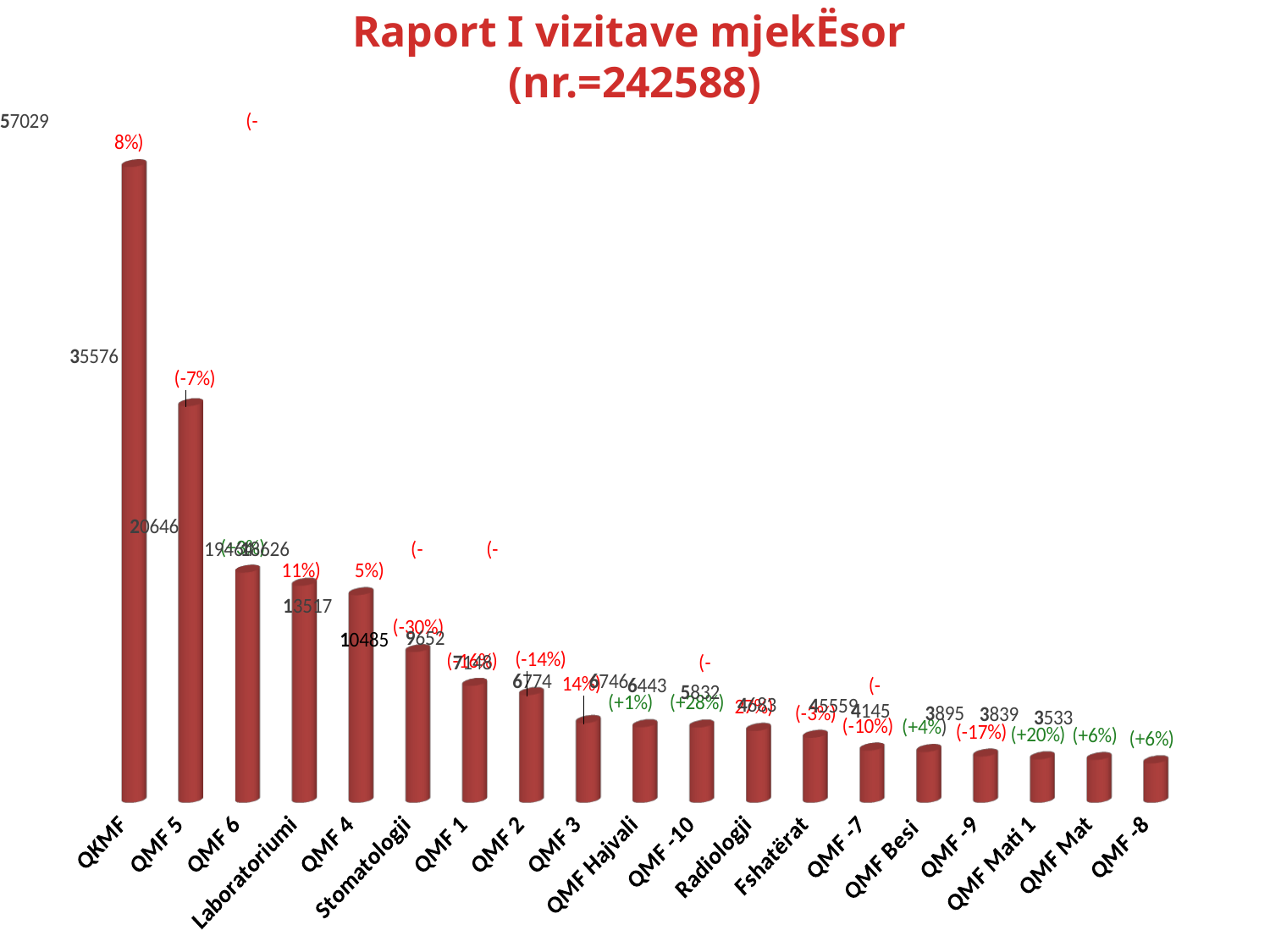
Which category has the lowest value? QMF -8 Do the values rise or fall from left to right along the x axis? fall What is the value for QMF 5? 35576 What is the value for QKMF? 57029 What type of chart is shown on the slide? bar chart Which category has the highest value? QKMF Which is larger, the value for QMF 6 or the value for QMF 4? QMF 6 What colour are the bars in the chart? red How many categories are shown on the x axis? 19 Which is larger, the value for Stomatologji or the value for QMF 2? Stomatologji What is the difference between the values for QKMF and QMF 5? 21453 What total number is given in the chart title? 242588